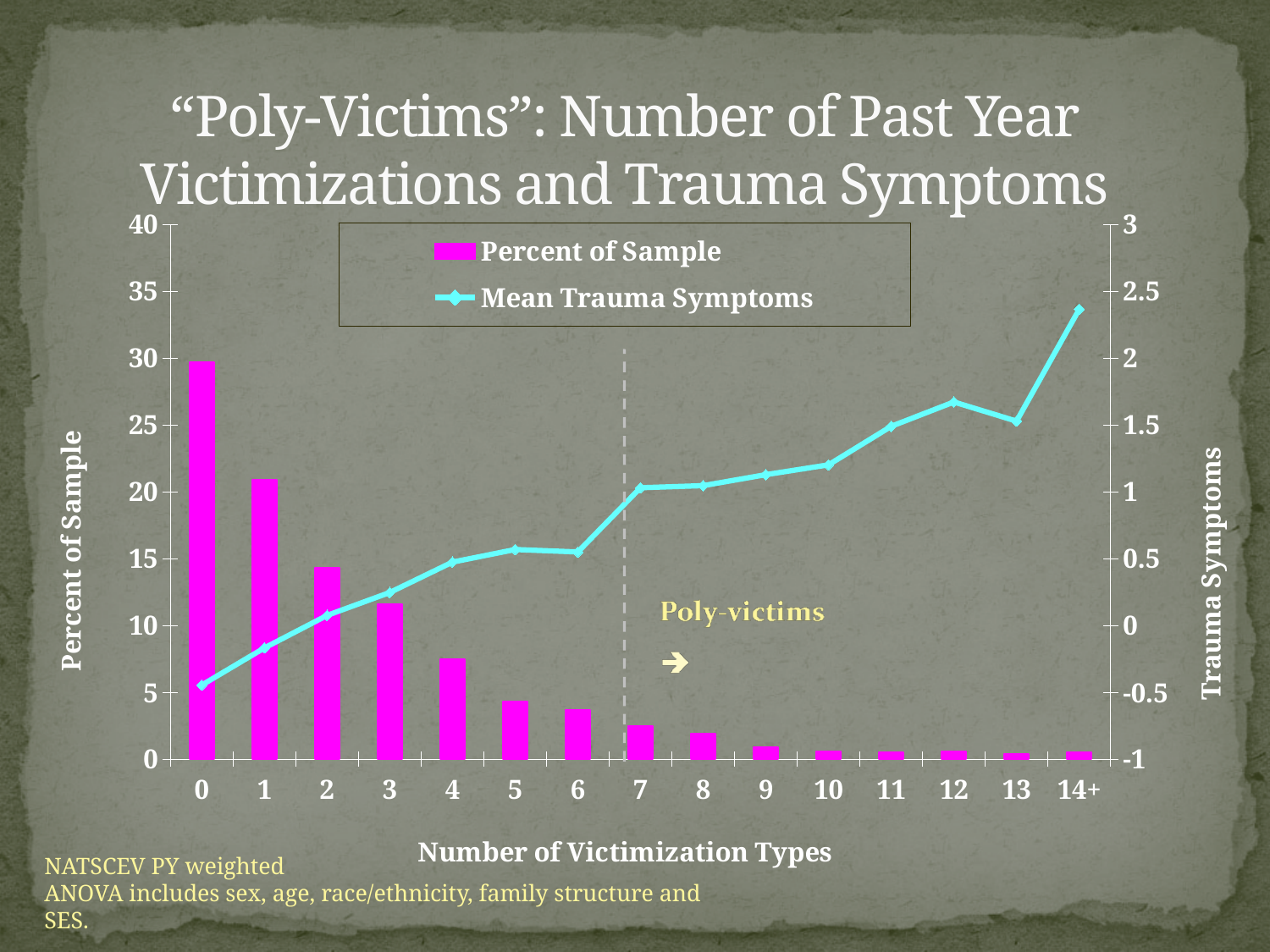
At which number of victimization types is Mean Trauma Symptoms lowest? 0 At which number of victimization types is Mean Trauma Symptoms highest? 14+ Is the Mean Trauma Symptoms value for 0 victimization types greater or less than 0? less Does the Mean Trauma Symptoms line generally rise or fall as the number of victimization types increases? rise How many categories are shown on the x axis (Number of Victimization Types)? 15 What are the two series named in the legend? Percent of Sample and Mean Trauma Symptoms How many series does the legend list? 2 Which number of victimization types has the highest Percent of Sample? 0 Is the Percent of Sample for 2 victimization types greater or less than 15? less What kind of chart is shown on the slide? A combination bar and line chart Is the Mean Trauma Symptoms value for 14+ victimization types greater or less than 2? greater